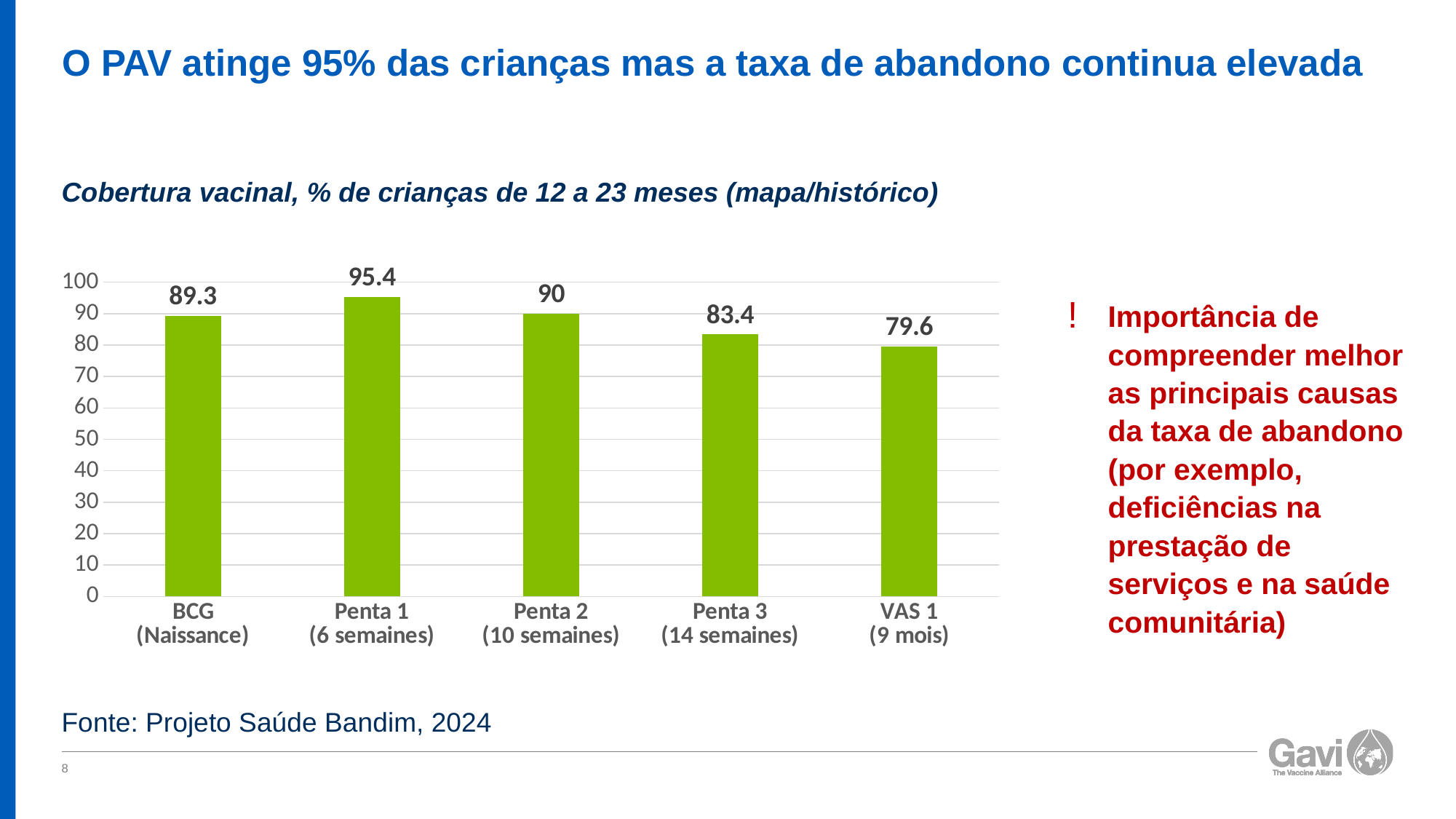
Do the values rise or fall from Penta 1 (6 semaines) to VAS 1 (9 mois)? fall What is the value shown for BCG (Naissance)? 89.3 Which category has the lowest coverage value? VAS 1 (9 mois) What is the vaccination coverage value for Penta 1 (6 semaines)? 95.4 What is the difference between the values for Penta 2 (10 semaines) and Penta 3 (14 semaines)? 6.6 What kind of chart is shown on the slide? bar chart What is the difference between the values for Penta 1 (6 semaines) and VAS 1 (9 mois)? 15.8 Which is larger, the value for BCG (Naissance) or the value for Penta 3 (14 semaines)? BCG (Naissance) What is the vaccination coverage value for VAS 1 (9 mois)? 79.6 How many categories are shown on the x axis of the chart? 5 Which category has the highest coverage value? Penta 1 (6 semaines) Is the value for Penta 3 (14 semaines) greater or less than 90? less